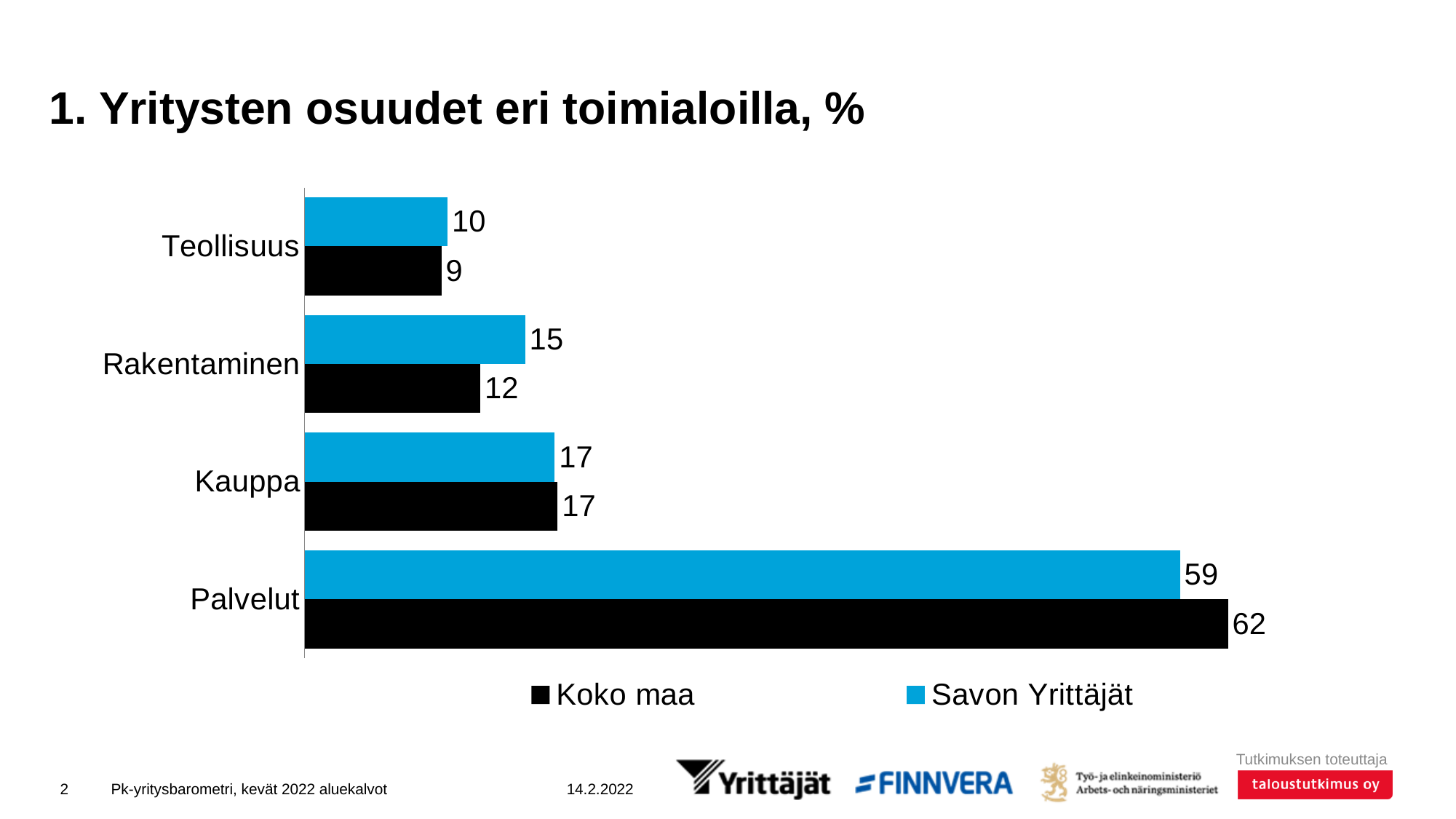
What is the title of the chart? 1. Yritysten osuudet eri toimialoilla, % Which colour represents the Savon Yrittäjät series? Blue How many series does the legend list? 2 What kind of chart is shown on the slide? Bar chart How many categories are shown on the chart? 4 Which category has the lowest value in the Koko maa series? Teollisuus Which is larger for Rakentaminen: the Koko maa value or the Savon Yrittäjät value? Savon Yrittäjät Which category has the highest value in the Savon Yrittäjät series? Palvelut What is the value for Rakentaminen in the Savon Yrittäjät series? 15 What is the difference between the Koko maa and Savon Yrittäjät values for Palvelut? 3 What is the value for Teollisuus in the Koko maa series? 9 What is the value for Palvelut in the Koko maa series? 62